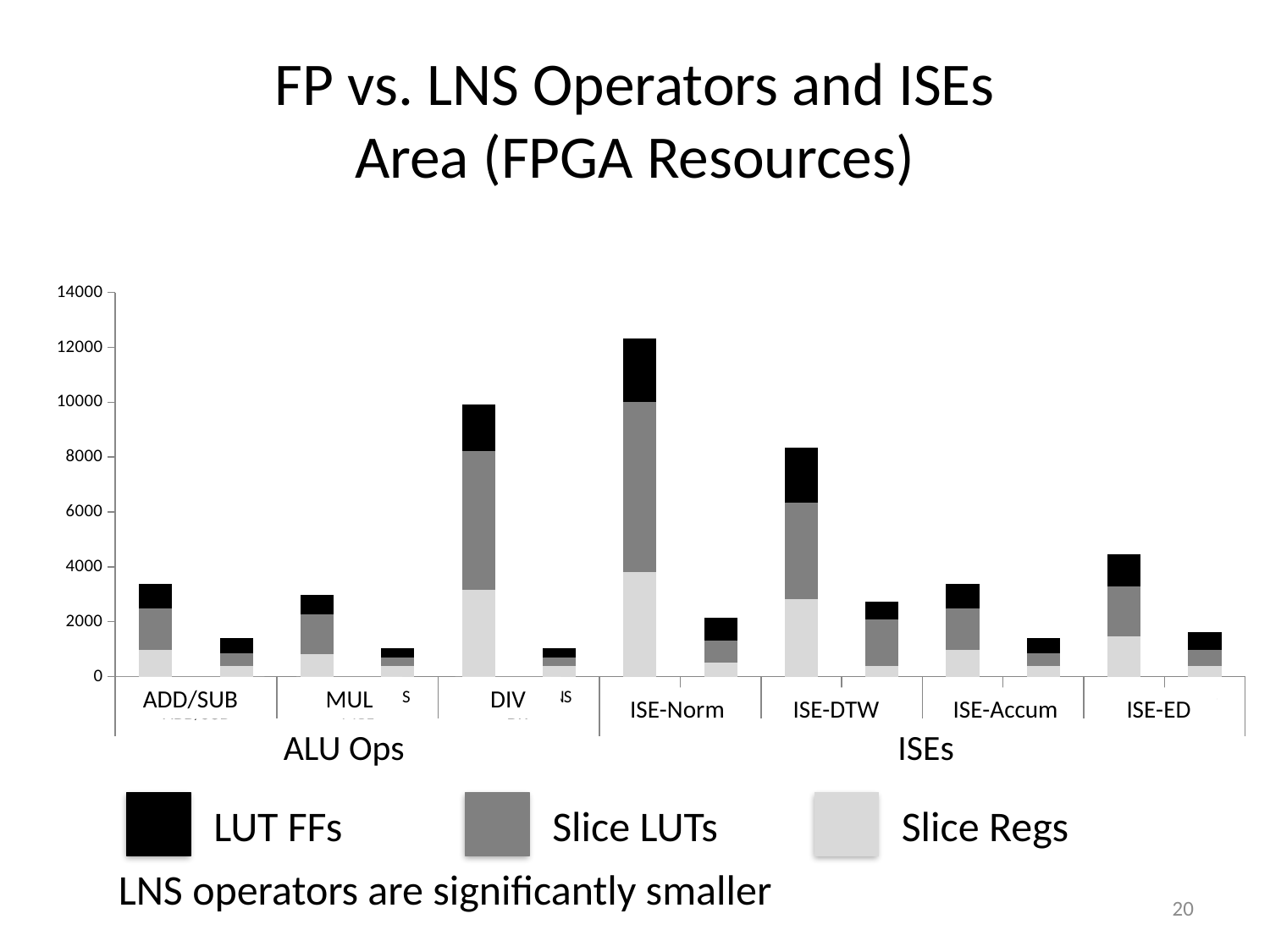
What are the two group labels shown beneath the category labels on the x axis? ALU Ops and ISEs What kind of chart is shown on the slide? stacked bar chart Is the tallest bar in the ADD/SUB category greater or less than 4000? less Is the tallest bar in the ISE-Norm category greater or less than 12000? greater How many labeled categories are shown along the x axis? 7 Is the tallest bar in the ISE-ED category greater or less than 6000? less Which category has the tallest stacked bar? ISE-Norm Which colour represents LUT FFs in the legend? black How many series does the legend list? 3 Which is taller: the tallest bar in DIV or the tallest bar in ISE-DTW? DIV